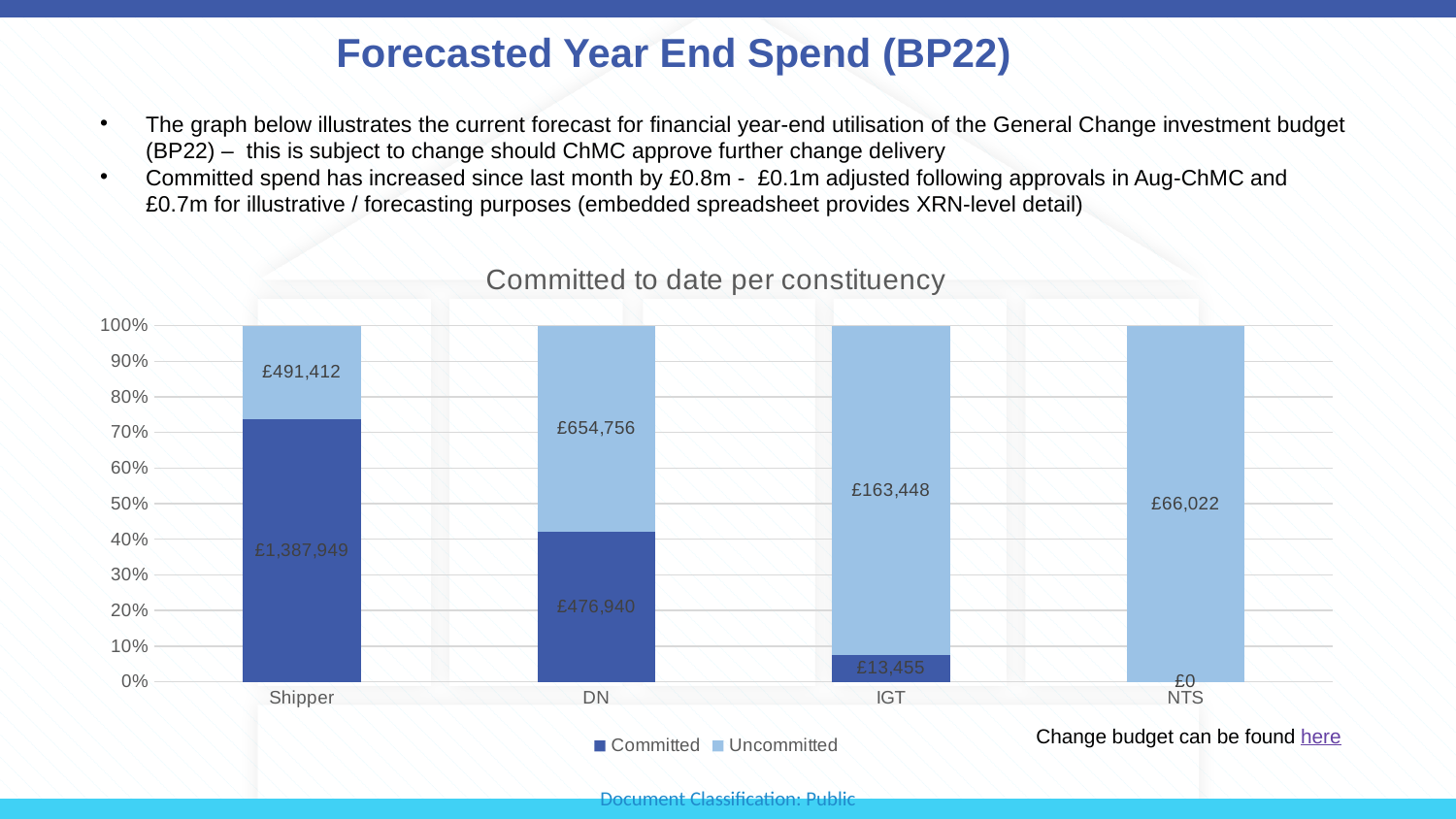
What is the difference between the Uncommitted and Committed values for DN? £177,816 What is the total of Committed and Uncommitted for IGT? £176,903 How many series does the legend list? 2 Which constituency has the highest Committed value? Shipper What is the Committed value for Shipper? £1,387,949 Which constituency has the lowest Uncommitted value? NTS Which is larger for Shipper, the Committed value or the Uncommitted value? Committed How many constituencies are shown on the x axis? 4 What is the Committed value for IGT? £13,455 What is the Committed value for NTS? £0 What is the Uncommitted value for DN? £654,756 What kind of chart is shown? Stacked bar chart